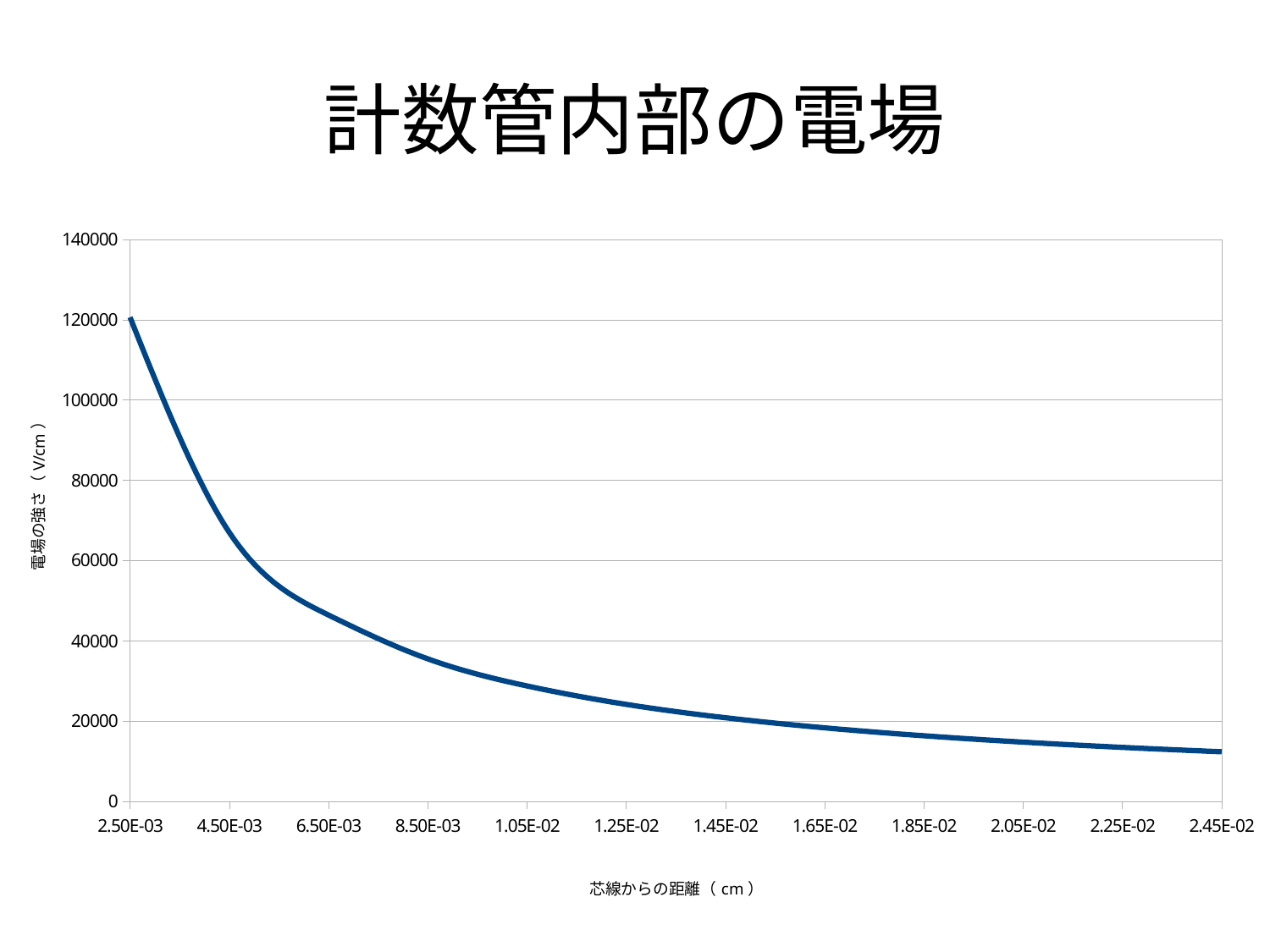
Is the value at a distance of 2.45E-02 cm greater or less than 20000 V/cm? less Which distance on the x axis has the highest electric field strength, 2.50E-03 cm or 2.45E-02 cm? 2.50E-03 What is the label of the y axis? 電場の強さ（V/cm） What kind of chart is shown on the slide? line chart What is the title of the chart? 計数管内部の電場 Is the value at a distance of 1.25E-02 cm greater or less than 40000 V/cm? less Is the value at a distance of 4.50E-03 cm greater or less than 40000 V/cm? greater Does the electric field strength rise or fall as the distance from the core wire increases? fall